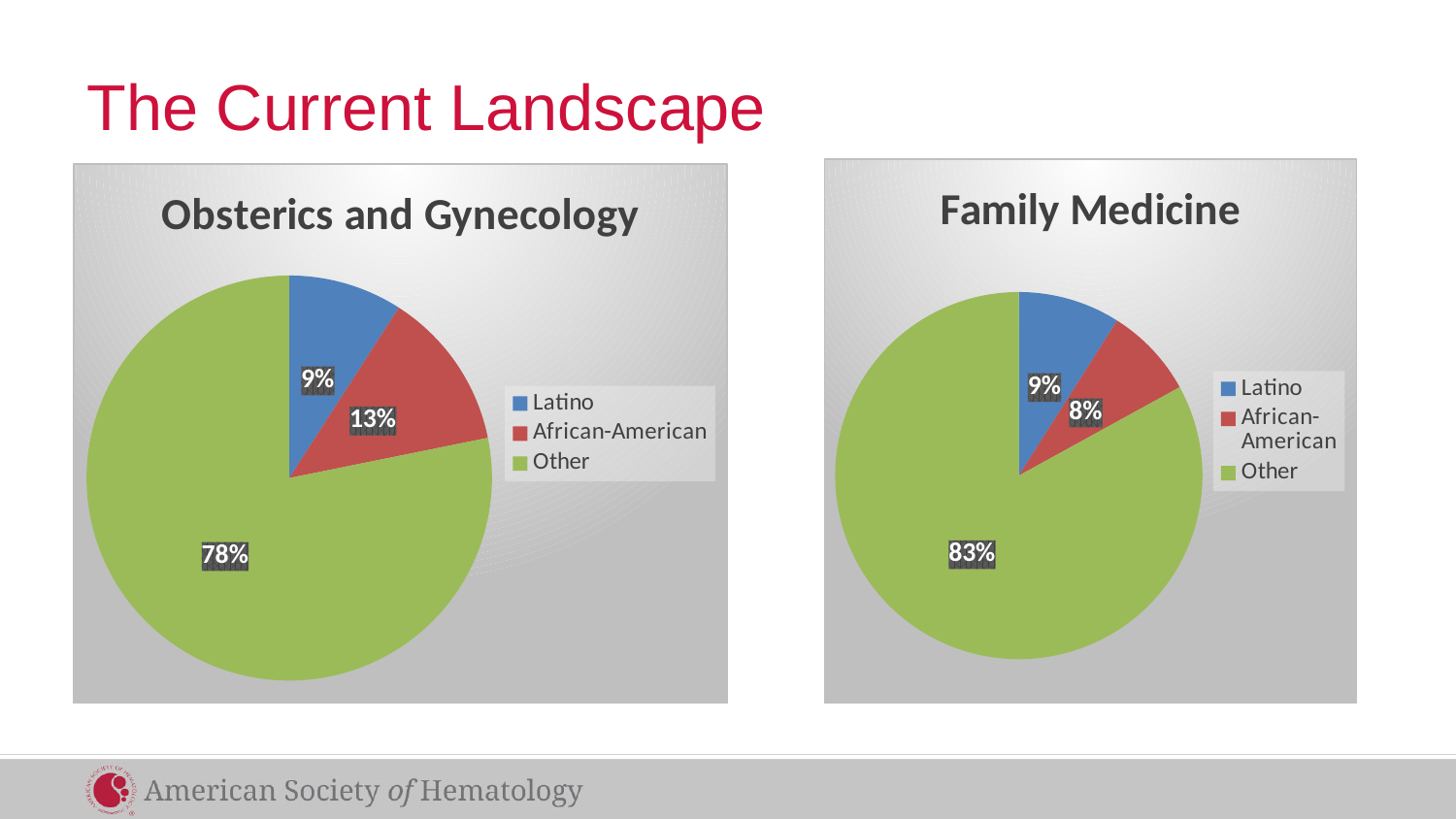
In the Obsterics and Gynecology chart, which category has the smallest slice? Latino In the Obsterics and Gynecology chart, which category has the largest slice? Other In the Family Medicine chart, which colour represents Other? Green In the Family Medicine chart, what is the value for African-American? 8% How many categories does the Family Medicine chart show? 3 In the Obsterics and Gynecology chart, what is the difference between the Other and African-American shares? 65% In the Obsterics and Gynecology chart, what is the value for Latino? 9% In the Family Medicine chart, which category has the smallest slice? African-American In the Family Medicine chart, what share of the pie is Other? 83% What kind of chart is the Obsterics and Gynecology chart? Pie chart In the Family Medicine chart, which is larger, Latino or African-American? Latino In the Obsterics and Gynecology chart, what share of the pie is African-American? 13%